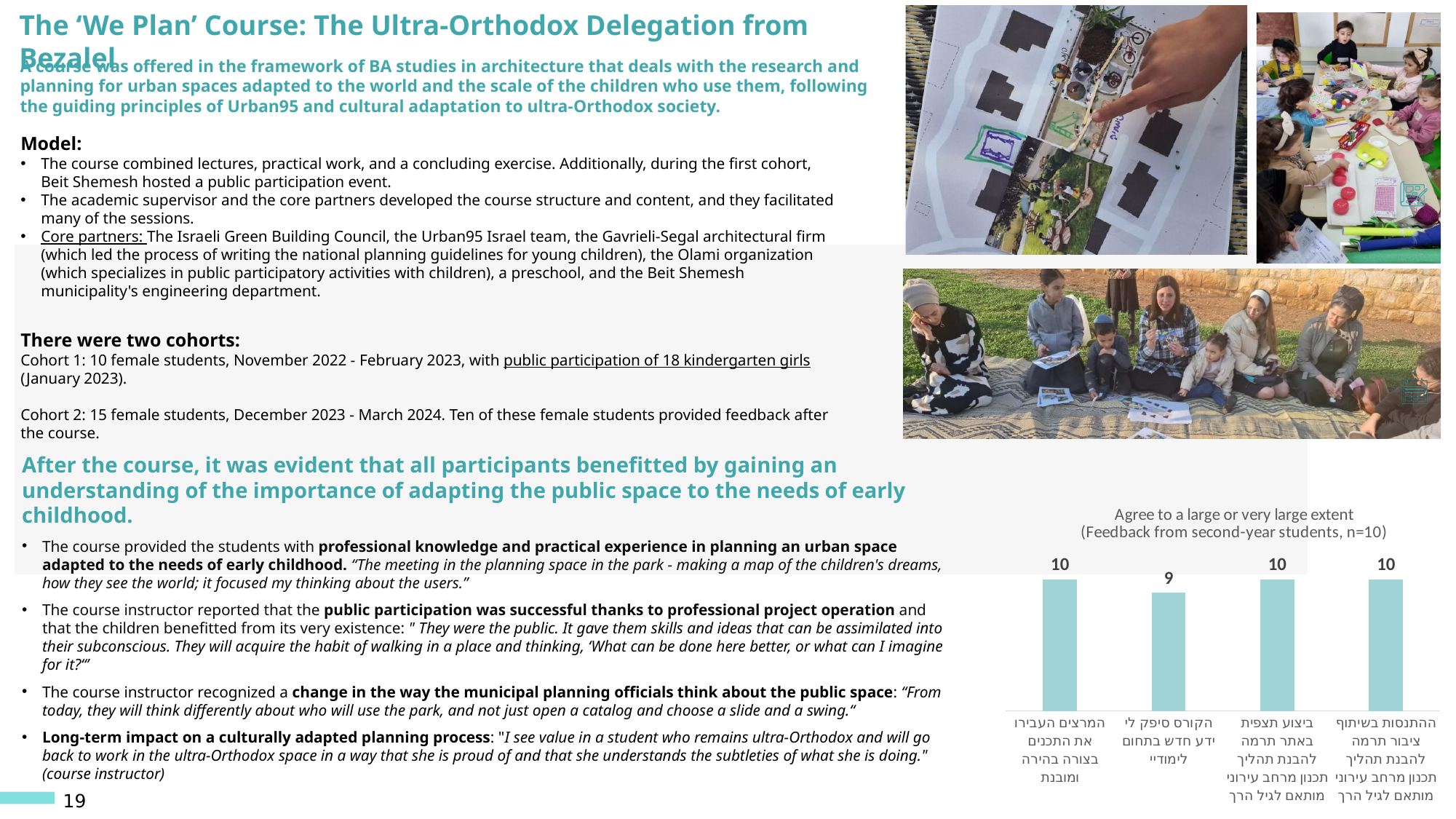
Which is larger: the value for 'ההתנסות בשיתוף ציבור תרמה להבנת תהליך תכנון מרחב עירוני מותאם לגיל הרך' or the value for 'הקורס סיפק לי ידע חדש בתחום לימודיי'? ההתנסות בשיתוף ציבור תרמה להבנת תהליך תכנון מרחב עירוני מותאם לגיל הרך What is the title of the chart? Agree to a large or very large extent (Feedback from second-year students, n=10) What is the value for the category 'הקורס סיפק לי ידע חדש בתחום לימודיי'? 9 What is the difference between the value for 'המרצים העבירו את התכנים בצורה בהירה ומובנת' and the value for 'הקורס סיפק לי ידע חדש בתחום לימודיי'? 1 Which category has the lowest value in the chart? הקורס סיפק לי ידע חדש בתחום לימודיי What is the value for the category 'המרצים העבירו את התכנים בצורה בהירה ומובנת'? 10 How many categories in the chart have a value of 10? 3 According to the chart title, how many students provided the feedback (n)? n=10 What is the value for the category 'ביצוע תצפית באתר תרמה להבנת תהליך תכנון מרחב עירוני מותאם לגיל הרך'? 10 How many categories (bars) does the chart show? 4 What type of chart is shown on the slide? bar chart